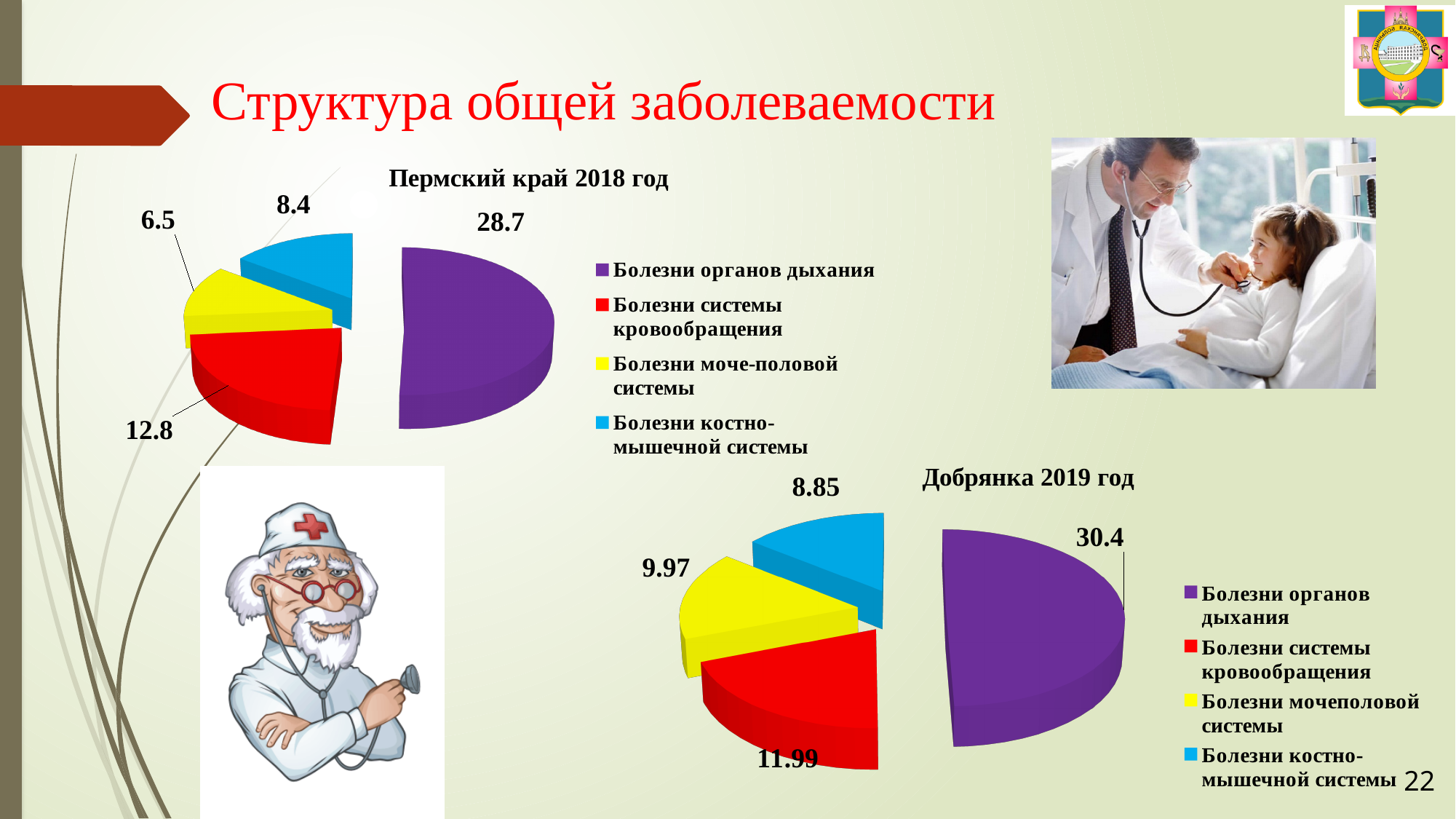
On the 'Пермский край 2018 год' chart, which colour represents Болезни костно-мышечной системы? Blue On the 'Пермский край 2018 год' chart, what is the value for Болезни моче-половой системы? 6.5 On the 'Добрянка 2019 год' chart, what is the value for Болезни органов дыхания? 30.4 On the 'Добрянка 2019 год' chart, which is larger: Болезни системы кровообращения or Болезни мочеполовой системы? Болезни системы кровообращения On the 'Добрянка 2019 год' chart, what is the value for Болезни костно-мышечной системы? 8.85 How many categories does the 'Добрянка 2019 год' chart show? 4 On the 'Пермский край 2018 год' chart, what is the value for Болезни органов дыхания? 28.7 On the 'Пермский край 2018 год' chart, what is the difference between Болезни органов дыхания and Болезни системы кровообращения? 15.9 What type of chart is 'Пермский край 2018 год'? Pie chart On the 'Добрянка 2019 год' chart, which category has the highest value? Болезни органов дыхания On the 'Пермский край 2018 год' chart, what is the value for Болезни системы кровообращения? 12.8 On the 'Пермский край 2018 год' chart, which category has the lowest value? Болезни моче-половой системы